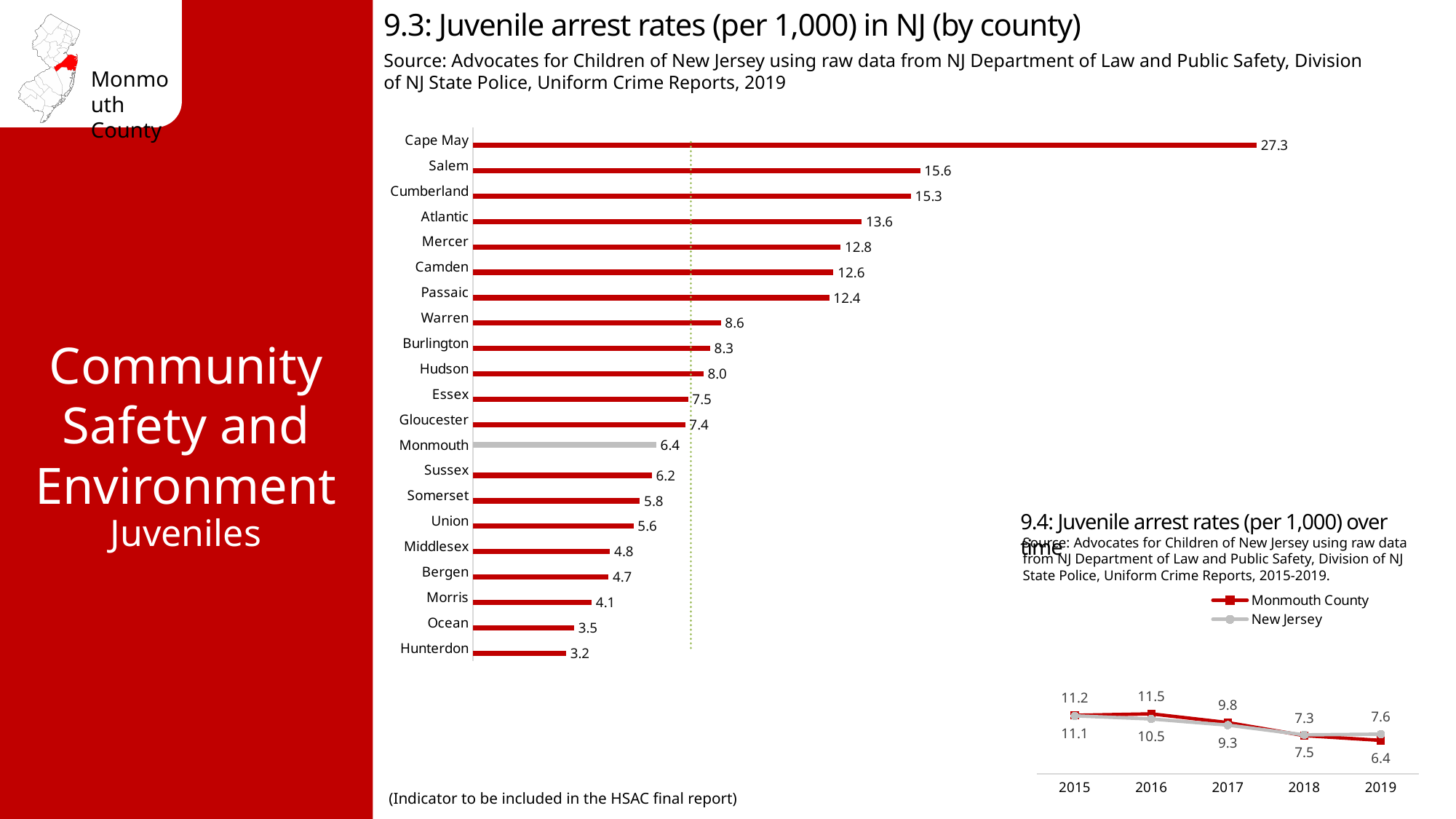
In chart 9.4 (juvenile arrest rates over time), what is the Monmouth County rate in 2019? 6.4 In chart 9.3 (juvenile arrest rates by county), how many counties are shown? 21 What kind of chart is chart 9.3 (juvenile arrest rates by county)? Bar chart In chart 9.3 (juvenile arrest rates by county), which has a higher rate, Passaic or Warren? Passaic In chart 9.3 (juvenile arrest rates by county), which county has the highest rate? Cape May In chart 9.3 (juvenile arrest rates by county), what is the juvenile arrest rate for Monmouth? 6.4 In chart 9.3 (juvenile arrest rates by county), which county has the lowest rate? Hunterdon In chart 9.4 (juvenile arrest rates over time), does the Monmouth County rate rise or fall from 2016 to 2019? Fall In chart 9.3 (juvenile arrest rates by county), what is the juvenile arrest rate for Cape May? 27.3 In chart 9.4 (juvenile arrest rates over time), how many series does the legend list? 2 In chart 9.3 (juvenile arrest rates by county), what is the difference between the rates for Salem and Cumberland? 0.3 In chart 9.3 (juvenile arrest rates by county), which county's bar is shown in gray instead of red? Monmouth